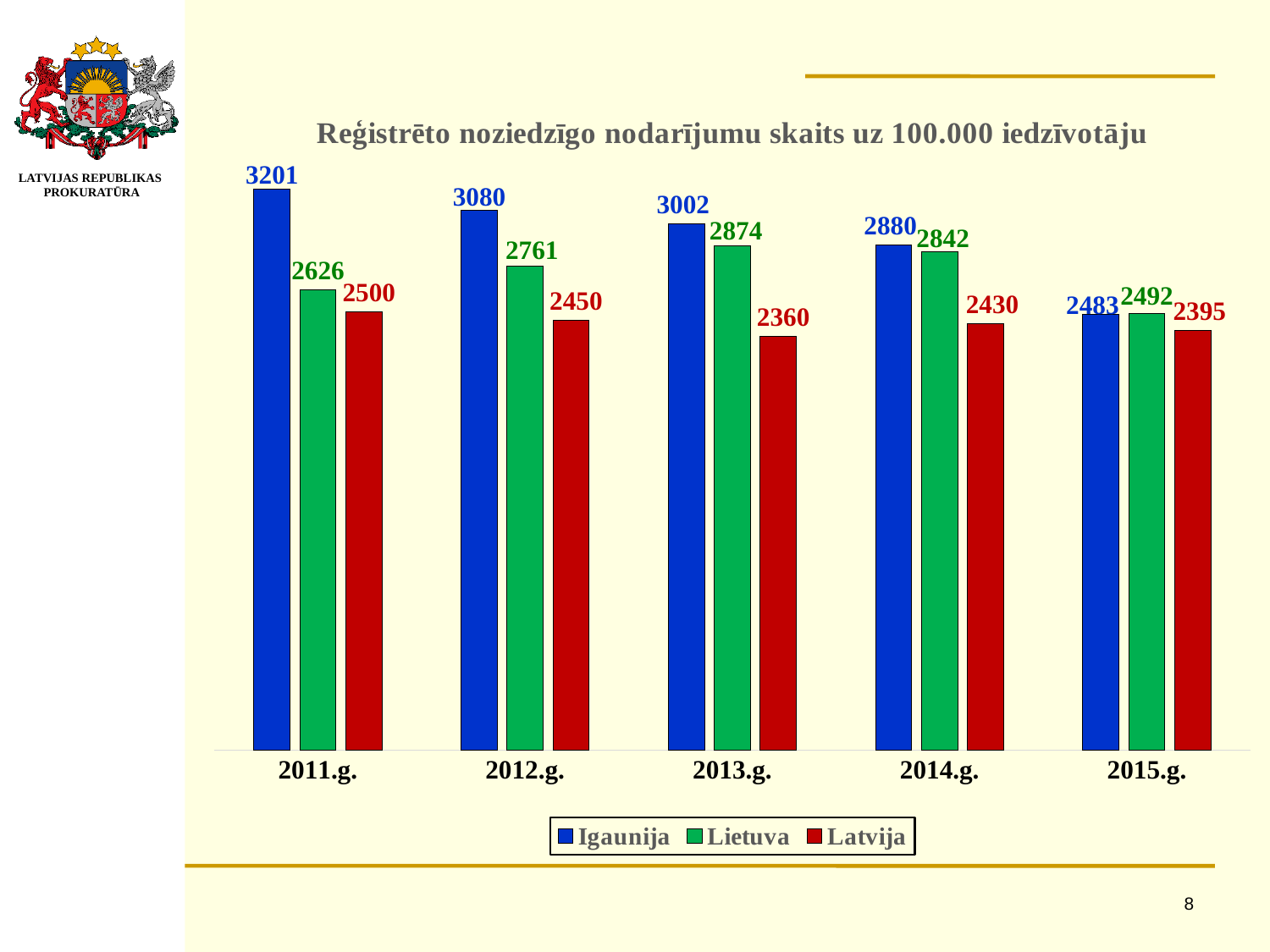
How many series does the legend list? 3 How many years are shown on the x axis? 5 Which series is shown in red in the legend? Latvija What is the value for Igaunija in 2011.g.? 3201 Does the value for Igaunija rise or fall from 2011.g. to 2015.g.? fall Which is larger in 2013.g., the value for Lietuva or the value for Latvija? Lietuva What is the value for Latvija in 2013.g.? 2360 What is the value for Lietuva in 2014.g.? 2842 What kind of chart is shown on the slide? bar chart What is the difference between the Igaunija and Latvija values in 2012.g.? 630 In which year is the value for Igaunija the highest? 2011.g. In which year is the value for Latvija the lowest? 2013.g.